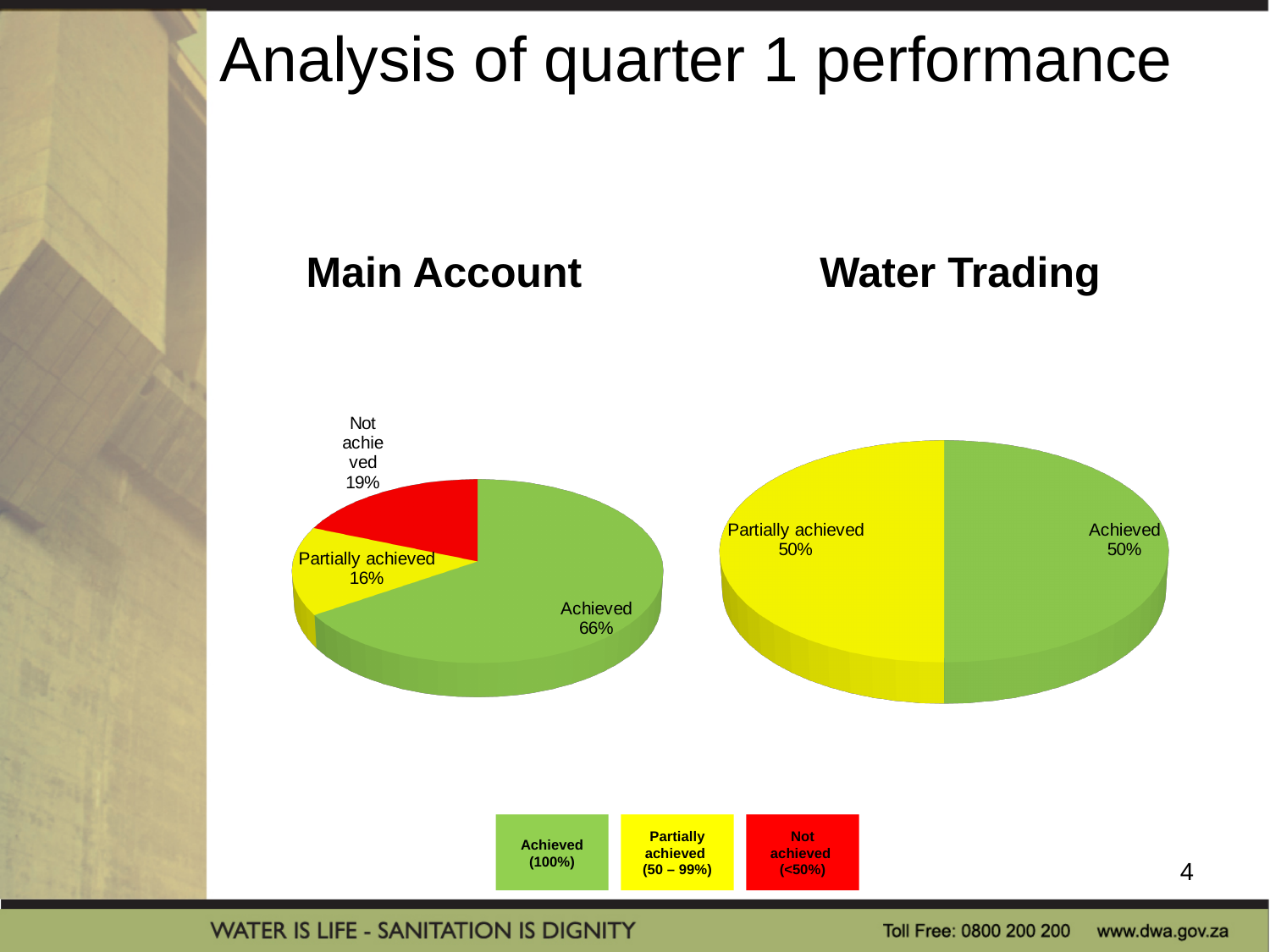
In the Main Account chart, what percentage is labelled Achieved? 66% In the Main Account chart, what is the difference between the Achieved and Not achieved percentages? 47% In the Main Account chart, what colour is the Not achieved slice? Red How many slices does the Water Trading chart have? 2 How many slices does the Main Account chart have? 3 What type of chart is the Water Trading chart? Pie chart In the Main Account chart, what percentage is labelled Partially achieved? 16% In the Main Account chart, which category has the smallest slice? Partially achieved In the Main Account chart, which category has the largest slice? Achieved In the Water Trading chart, what percentage is labelled Achieved? 50% In the Main Account chart, which is larger, Not achieved or Partially achieved? Not achieved In the Main Account chart, what percentage is labelled Not achieved? 19%